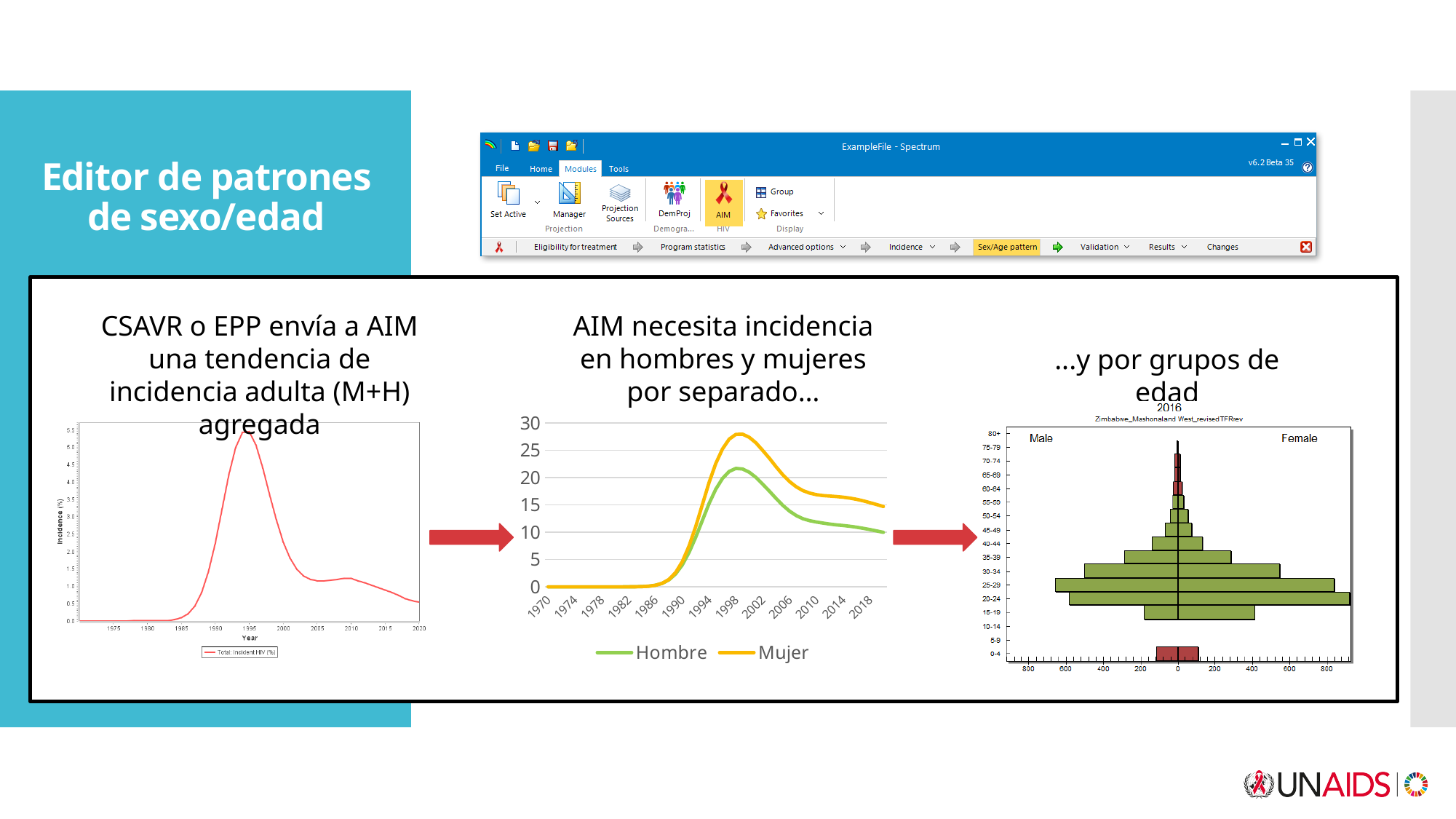
In the right chart titled 2016, is the Female value for the 20-24 age group greater or less than 800? greater In the middle chart, what is the value of the Hombre series in 1970? 0 In the middle chart, do the Hombre and Mujer values rise or fall between 1998 and 2018? fall In the left chart, is the value in 2020 greater or less than 1.0? less In the middle chart, is the peak value of the Mujer series greater or less than 25? greater How many series does the legend of the middle chart list? 2 What kind of chart is the right chart titled 2016 showing Male and Female by age group? bar chart In the right chart titled 2016, which age group has the largest Female bar? 20-24 In the middle chart, which series is higher around 1998, Hombre or Mujer? Mujer What kind of chart is the middle chart with the Hombre and Mujer series? line chart